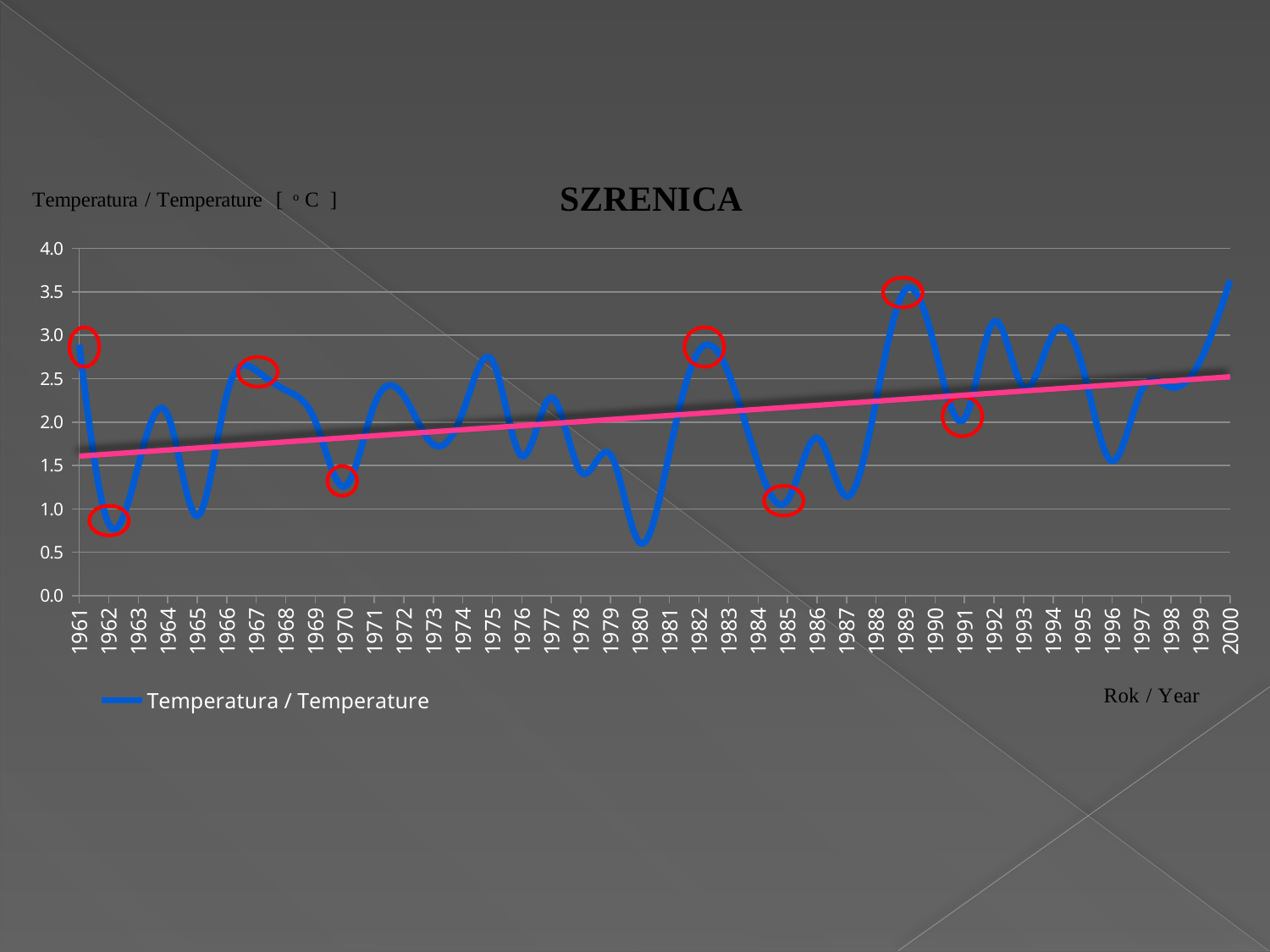
Does the pink trend line rise or fall from 1961 to 2000? rise Which year has the larger temperature value, 1989 or 1980? 1989 Is the temperature value for 1989 greater or less than 3.0? greater How many series does the legend list? 1 How many years are plotted along the x axis? 40 Is the temperature value for 1962 greater or less than 1.0? less Is the temperature value for 1996 greater or less than 2.0? less What kind of chart is shown on the slide? line chart What is the title of the chart? SZRENICA Which year has the lowest temperature value on the chart? 1980